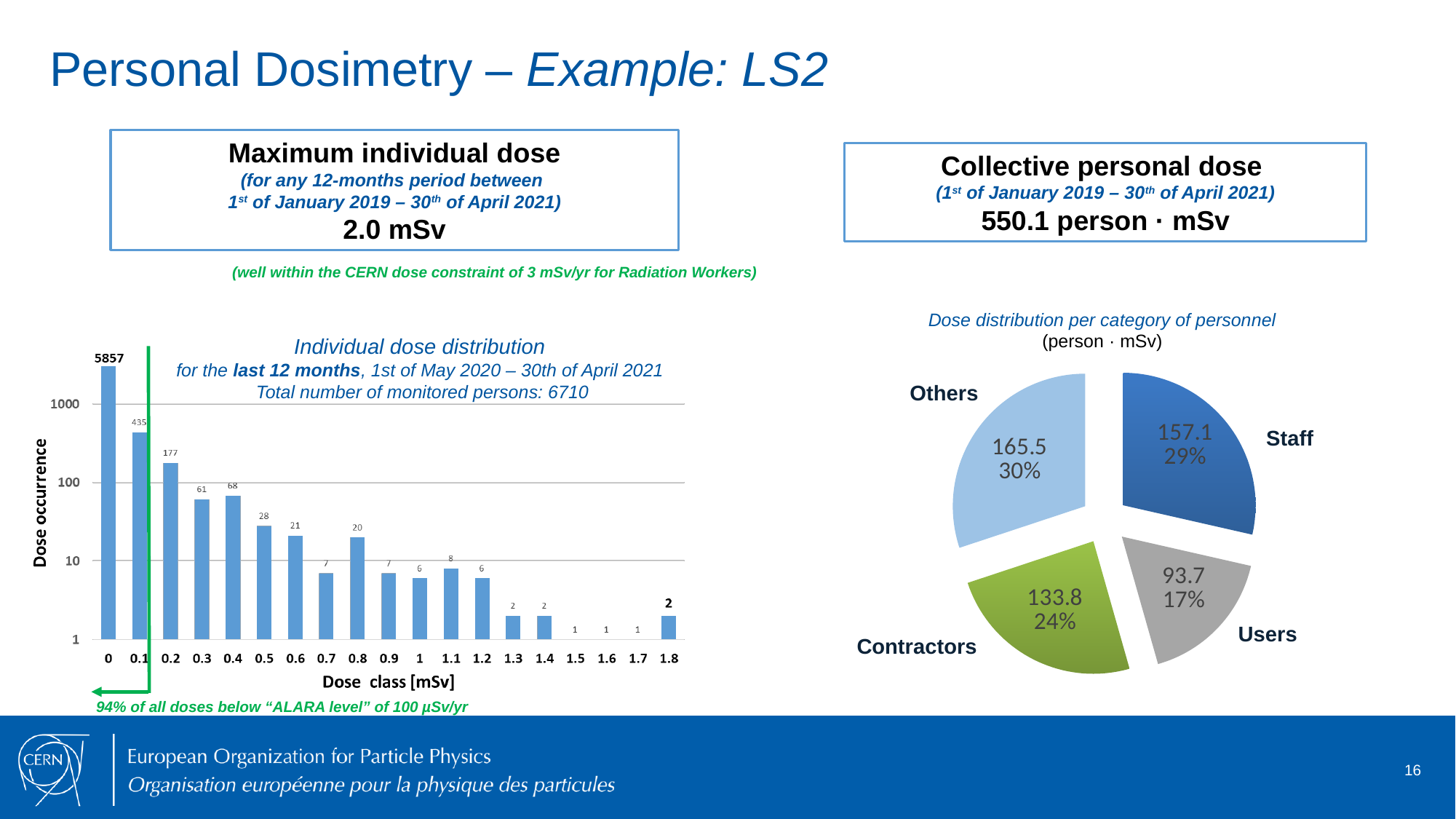
In the Individual dose distribution chart, what is the dose occurrence for dose class 0.2 mSv? 177 In the Dose distribution per category of personnel pie chart, what is the value for Contractors? 133.8 In the Individual dose distribution chart, which has a higher dose occurrence: dose class 0.3 or dose class 0.4? 0.4 In the Individual dose distribution chart, which dose class has the highest dose occurrence? 0 How many dose classes are shown on the x axis of the Individual dose distribution chart? 19 How many categories are shown in the Dose distribution per category of personnel pie chart? 4 In the Individual dose distribution chart, what is the difference in dose occurrence between dose class 0.1 and dose class 0.2? 258 What kind of chart is the Individual dose distribution chart? bar chart In the Dose distribution per category of personnel pie chart, what share does Others have? 30% In the Dose distribution per category of personnel pie chart, what is the difference between the Staff and Users values? 63.4 In the Individual dose distribution chart, what is the dose occurrence for dose class 0 mSv? 5857 In the Dose distribution per category of personnel pie chart, which category has the smallest value? Users